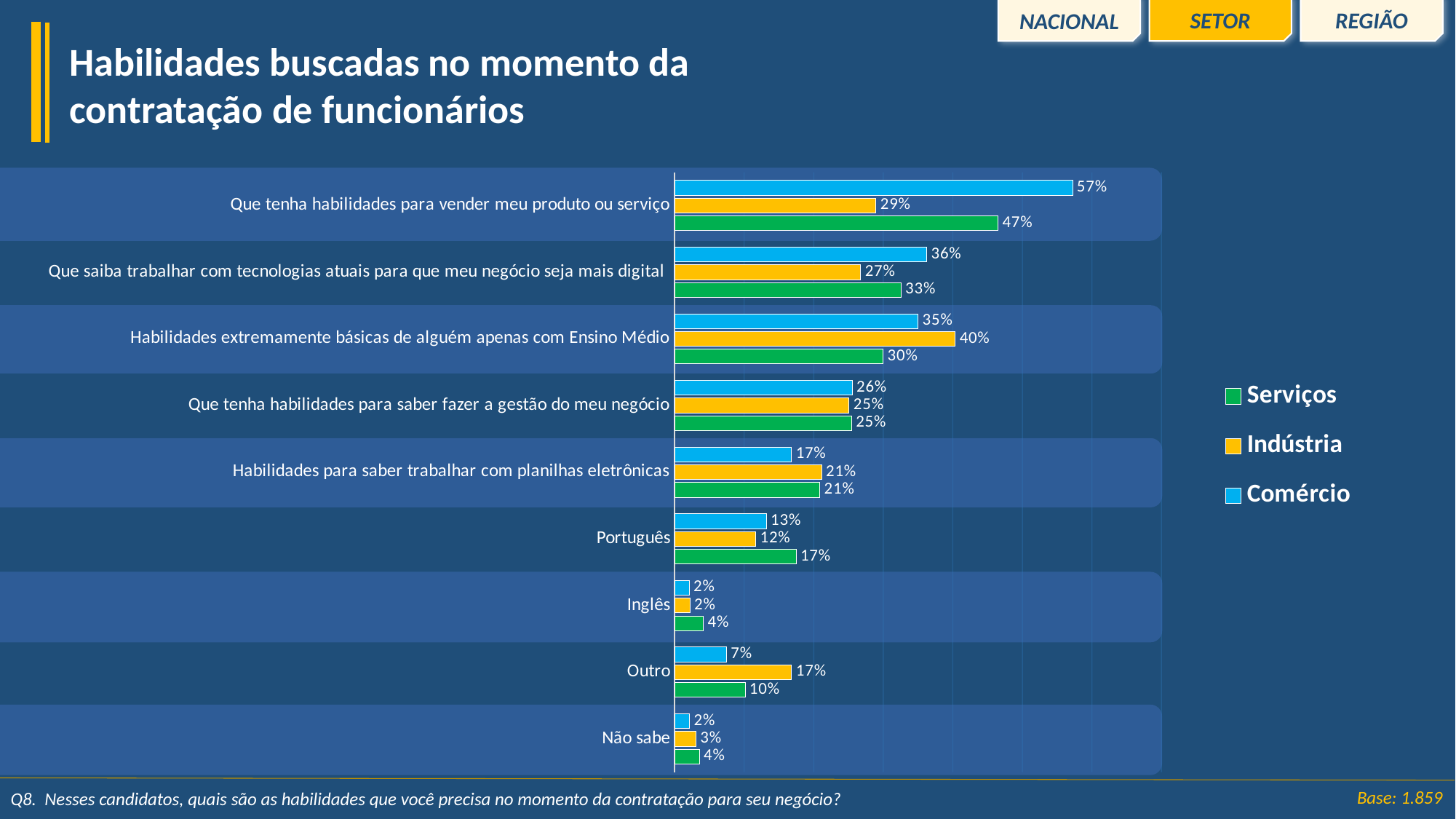
What is the Indústria value for "Outro"? 17% How many series does the legend list? 3 How many categories are shown in the chart? 9 What is the Serviços value for "Português"? 17% What is the Comércio value for "Que tenha habilidades para vender meu produto ou serviço"? 57% Which category has the lowest Indústria value? Inglês What is the difference between the Comércio and Indústria values for "Que tenha habilidades para vender meu produto ou serviço"? 28% For "Habilidades extremamente básicas de alguém apenas com Ensino Médio", which is larger: the Indústria value or the Serviços value? Indústria What is the Indústria value for "Habilidades extremamente básicas de alguém apenas com Ensino Médio"? 40% Which series is shown in green in the legend? Serviços What kind of chart is shown on the slide? Bar chart Which category has the highest Comércio value? Que tenha habilidades para vender meu produto ou serviço